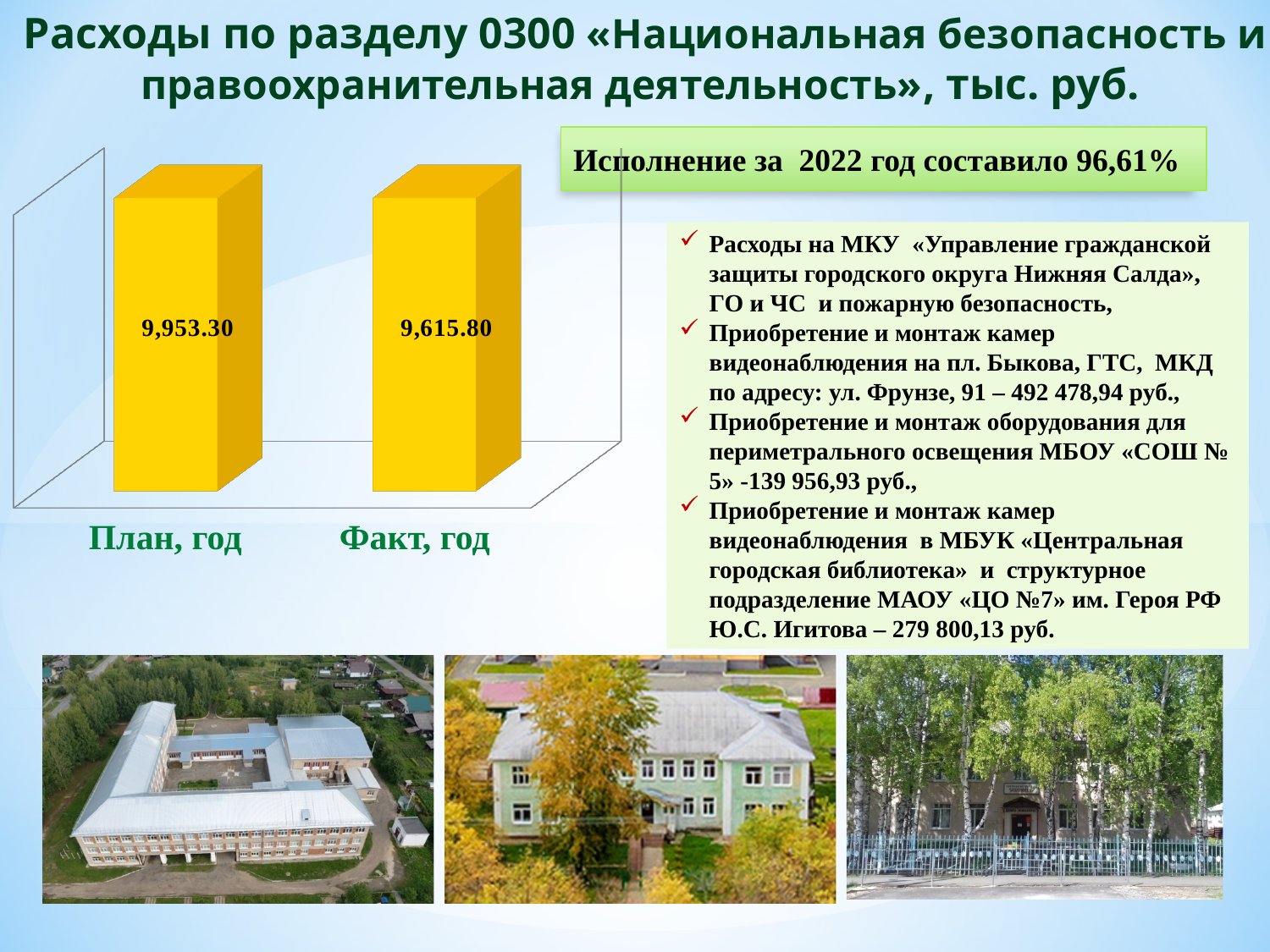
What is the value for Факт, год? 9,615.80 What is the value for План, год? 9,953.30 What colour are the bars in the chart? yellow Which category has the lowest value? Факт, год Do the values rise or fall from План, год to Факт, год? fall What is the difference between the values for План, год and Факт, год? 337.50 Which is larger, the value for План, год or the value for Факт, год? План, год What unit of measurement is stated in the slide title for the chart values? тыс. руб. How many categories are shown in the chart? 2 What kind of chart is shown on the slide? bar chart Which category has the highest value? План, год